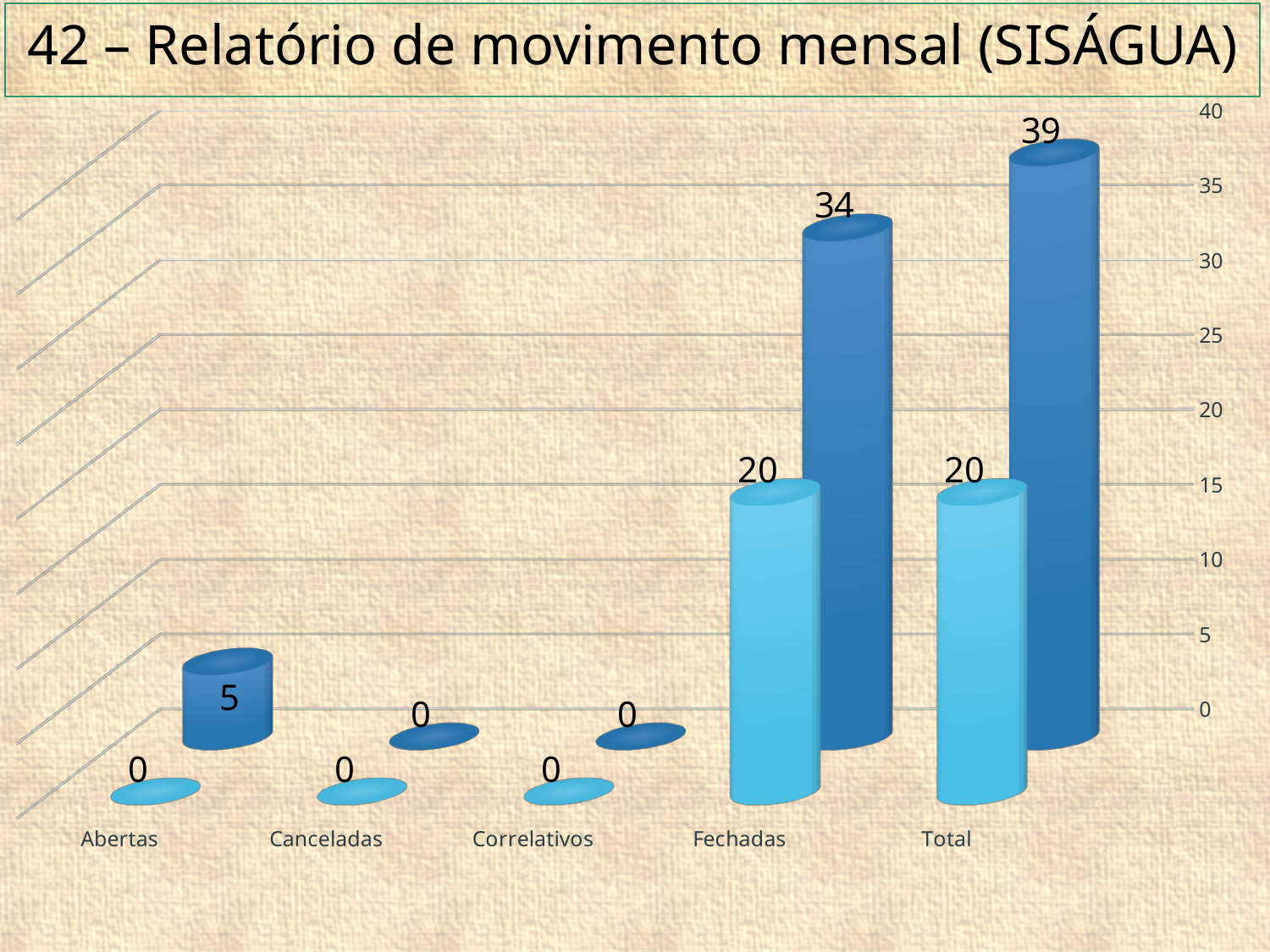
What is the value of the light blue bar for Fechadas? 20 Which is larger for Total: the dark blue bar or the light blue bar? the dark blue bar Which category has the highest dark blue bar? Total What is the value of the light blue bar for Canceladas? 0 What kind of chart is shown on the slide? bar chart What is the value of the dark blue bar for Total? 39 For Fechadas, what is the difference between the dark blue bar and the light blue bar? 14 What is the difference between the dark blue bars for Total and Fechadas? 5 What is the value of the dark blue bar for Abertas? 5 What is the title of the slide containing the chart? 42 – Relatório de movimento mensal (SISÁGUA) How many categories are shown on the x axis? 5 What is the value of the dark blue bar for Fechadas? 34